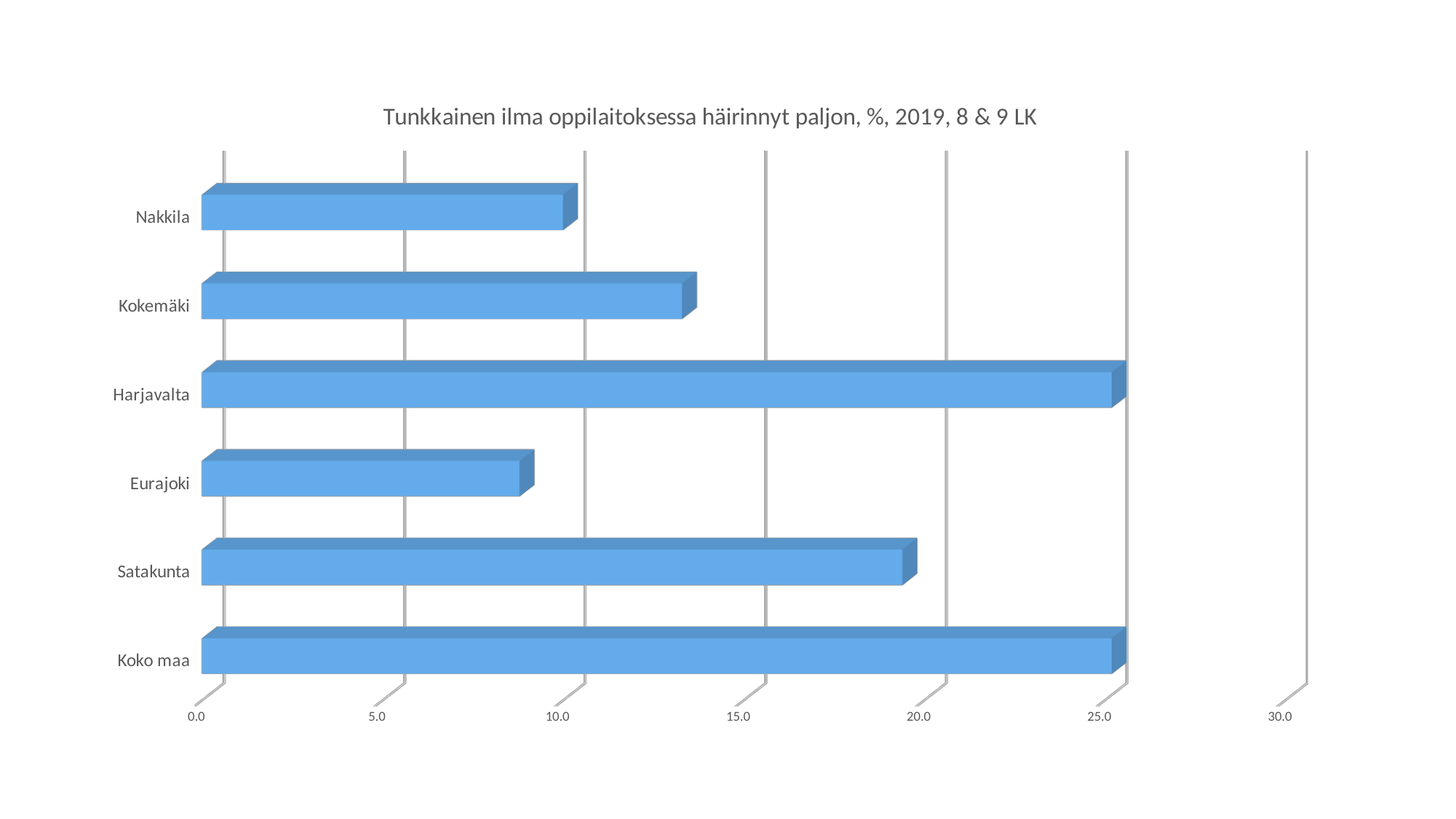
Which has the larger value, Satakunta or Kokemäki? Satakunta Is the value for Harjavalta greater or less than 20.0? greater What is the title of the chart? Tunkkainen ilma oppilaitoksessa häirinnyt paljon, %, 2019, 8 & 9 LK What is the highest value shown on the horizontal axis? 30.0 Is the value for Eurajoki greater or less than 10.0? less Is the value for Kokemäki greater or less than 15.0? less How many categories are plotted in the chart? 6 Which has the larger value, Harjavalta or Nakkila? Harjavalta What kind of chart is shown on the slide? Bar chart Which category has the lowest value in the chart? Eurajoki